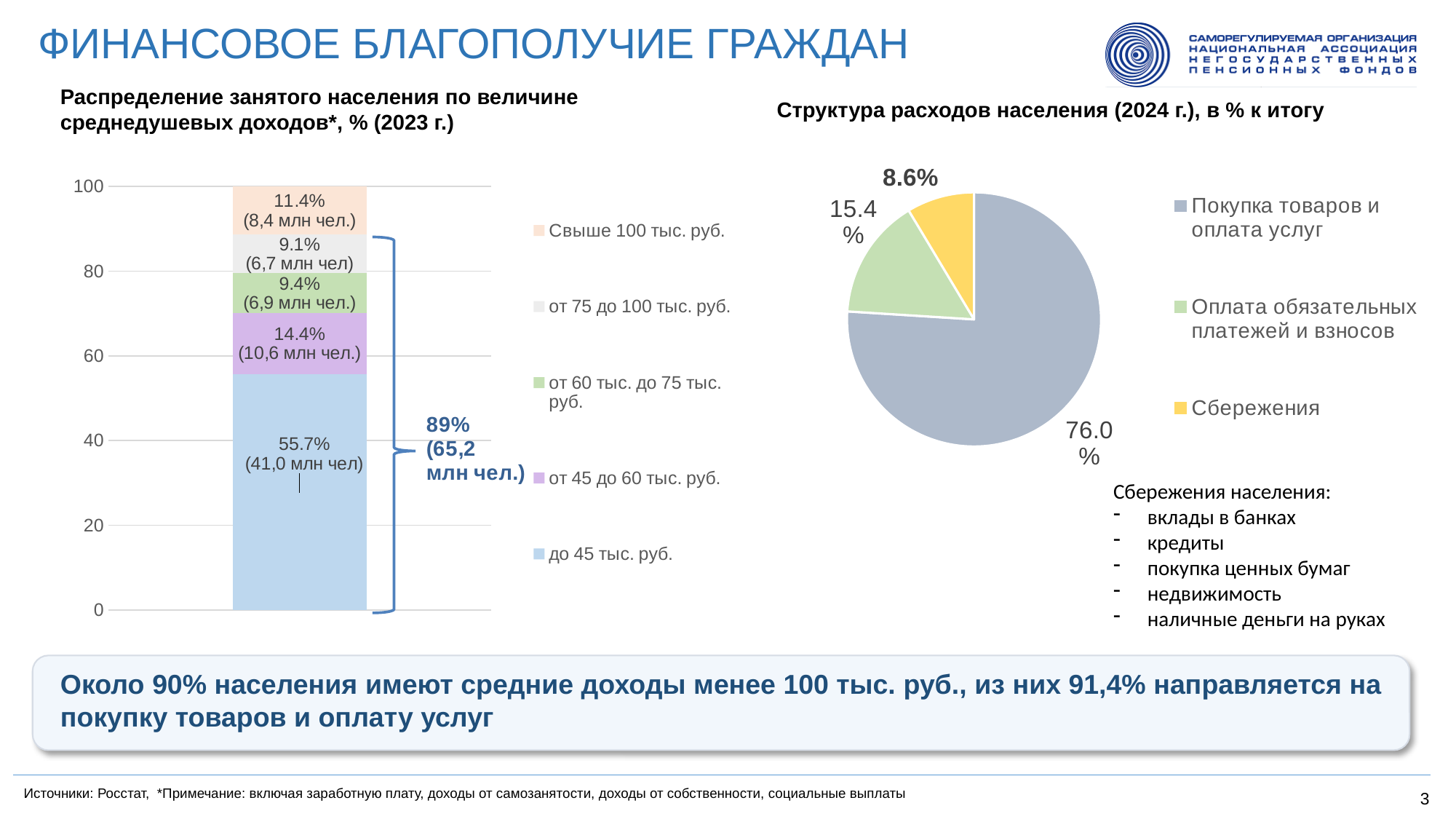
In the left chart, how many million people are in the category от 45 до 60 тыс. руб.? 10,6 млн чел. In the right chart, what share is Оплата обязательных платежей и взносов? 15.4% In the left chart, what percentage corresponds to the category Свыше 100 тыс. руб.? 11.4% What type of chart is the left chart? Stacked bar chart In the left chart, what is the difference in percentage points between the categories от 45 до 60 тыс. руб. and от 60 тыс. до 75 тыс. руб.? 5.0 In the left chart (Распределение занятого населения по величине среднедушевых доходов), what percentage of the employed population has income до 45 тыс. руб.? 55.7% In the right chart, which category has the largest slice? Покупка товаров и оплата услуг What type of chart is the right chart? Pie chart In the right chart (Структура расходов населения), what share is Сбережения? 8.6% In the left chart, how many income categories does the legend list? 5 In the left chart, which income category has the largest share? до 45 тыс. руб. In the left chart, which income category has the smallest share? от 75 до 100 тыс. руб.